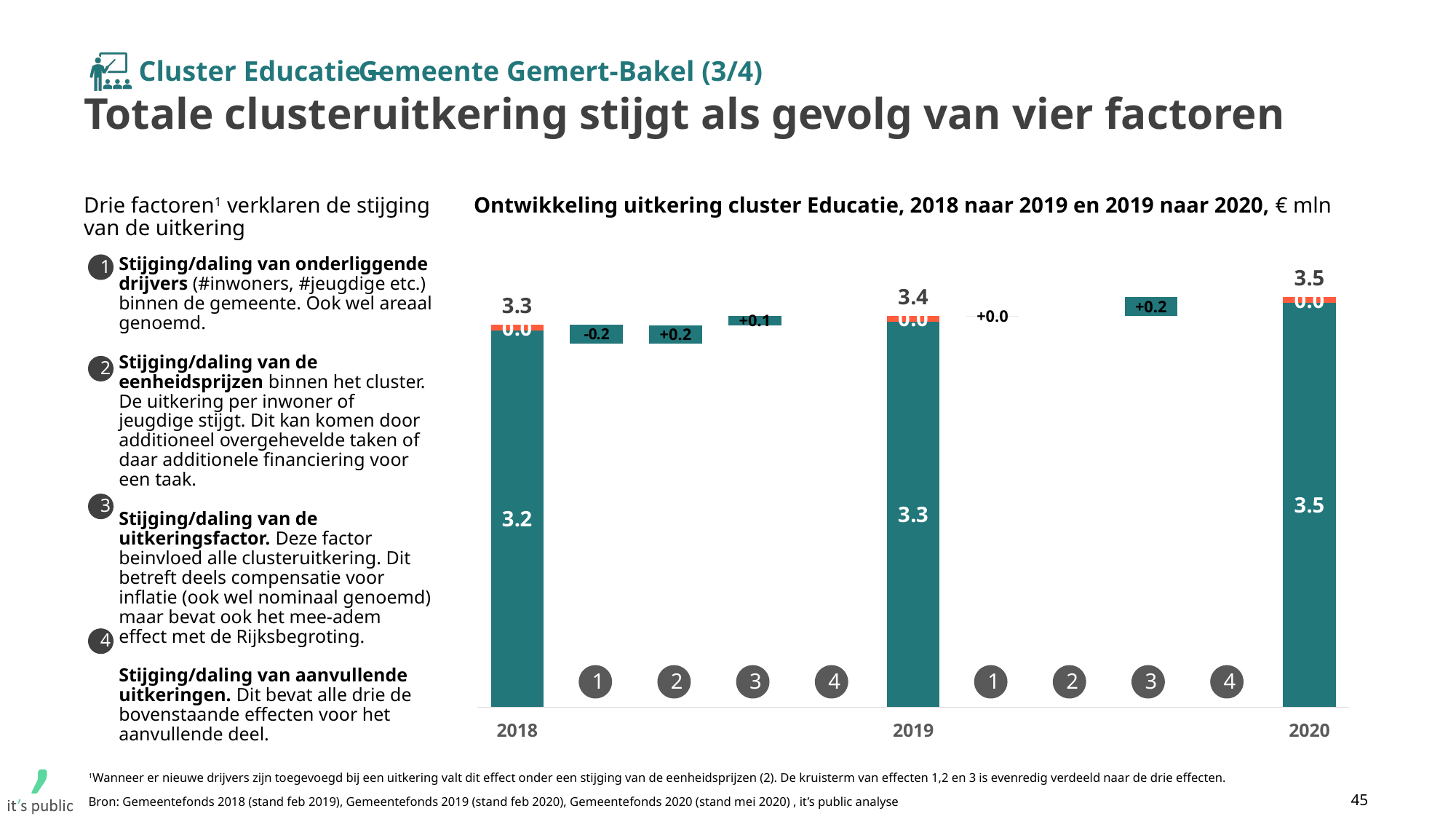
Does the total uitkering rise or fall from 2018 to 2020? rise What is the effect of factor 2 on the uitkering from 2018 to 2019? +0.2 What is the effect of factor 1 on the uitkering from 2018 to 2019? -0.2 What is the total uitkering for cluster Educatie in 2020? 3.5 What kind of chart is shown on the slide? bar chart What is the effect of factor 3 on the uitkering from 2018 to 2019? +0.1 What is the value of the large teal segment of the 2019 bar? 3.3 What is the total uitkering for cluster Educatie in 2019? 3.4 What is the effect of factor 3 on the uitkering from 2019 to 2020? +0.2 Which year has the highest total uitkering? 2020 What is the total uitkering for cluster Educatie in 2018? 3.3 By how much does the total uitkering in 2020 exceed the total in 2018? 0.2